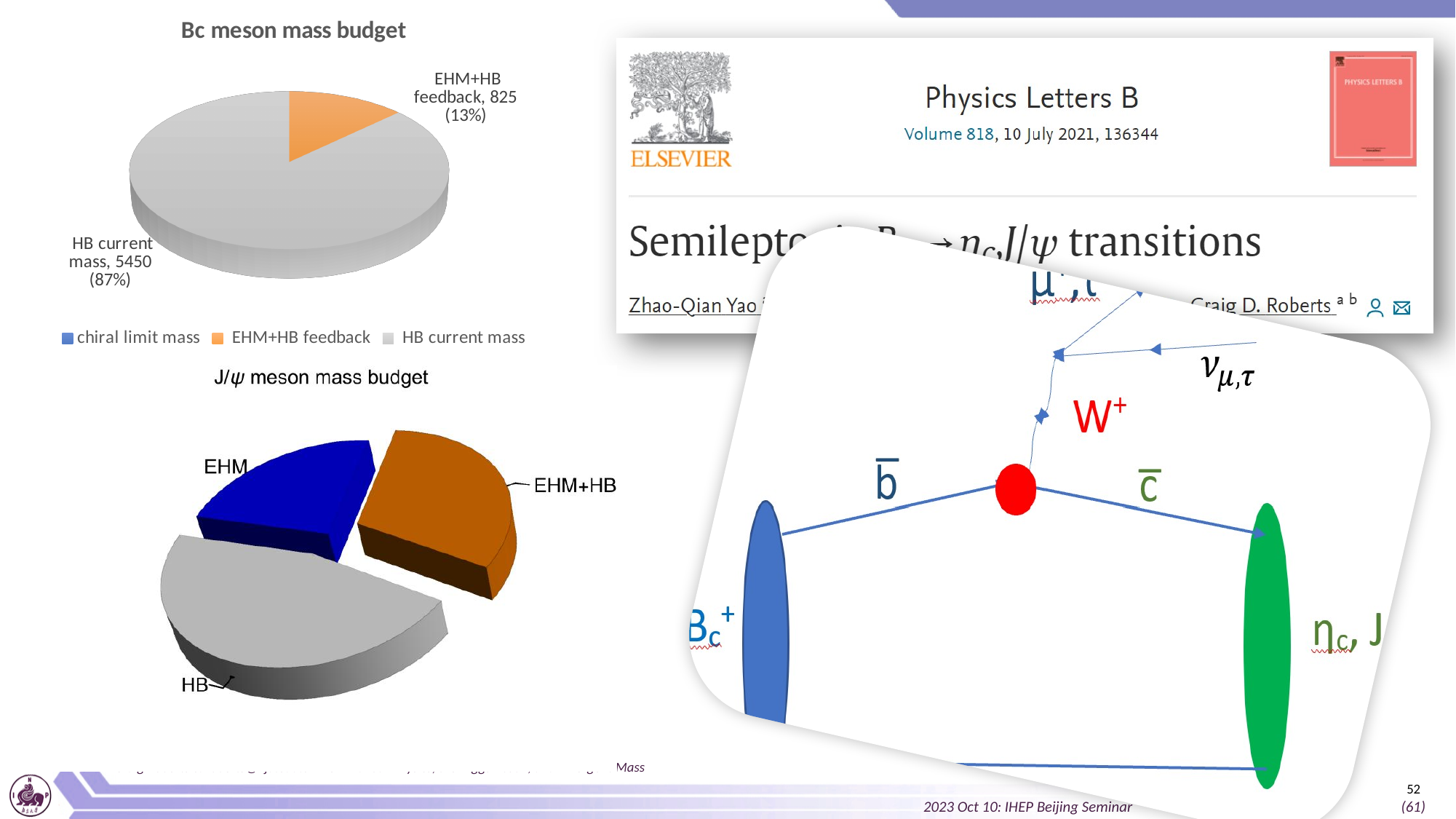
In the Bc meson mass budget chart, what is the value for EHM+HB feedback? 825 In the Bc meson mass budget chart, which slice is the largest? HB current mass In the Bc meson mass budget chart, what is the value for HB current mass? 5450 In the Bc meson mass budget chart, what is the difference between the HB current mass value and the EHM+HB feedback value? 4625 In the Bc meson mass budget chart, what share of the pie is HB current mass? 87% In the J/ψ meson mass budget chart, how many slices are shown? 3 What kind of chart is the Bc meson mass budget chart? Pie chart In the Bc meson mass budget chart, which is larger, HB current mass or EHM+HB feedback? HB current mass In the J/ψ meson mass budget chart, what colour is the EHM slice? Blue In the Bc meson mass budget chart, what share of the pie is EHM+HB feedback? 13% In the J/ψ meson mass budget chart, which slice is the largest? HB In the Bc meson mass budget chart, how many entries does the legend list? 3